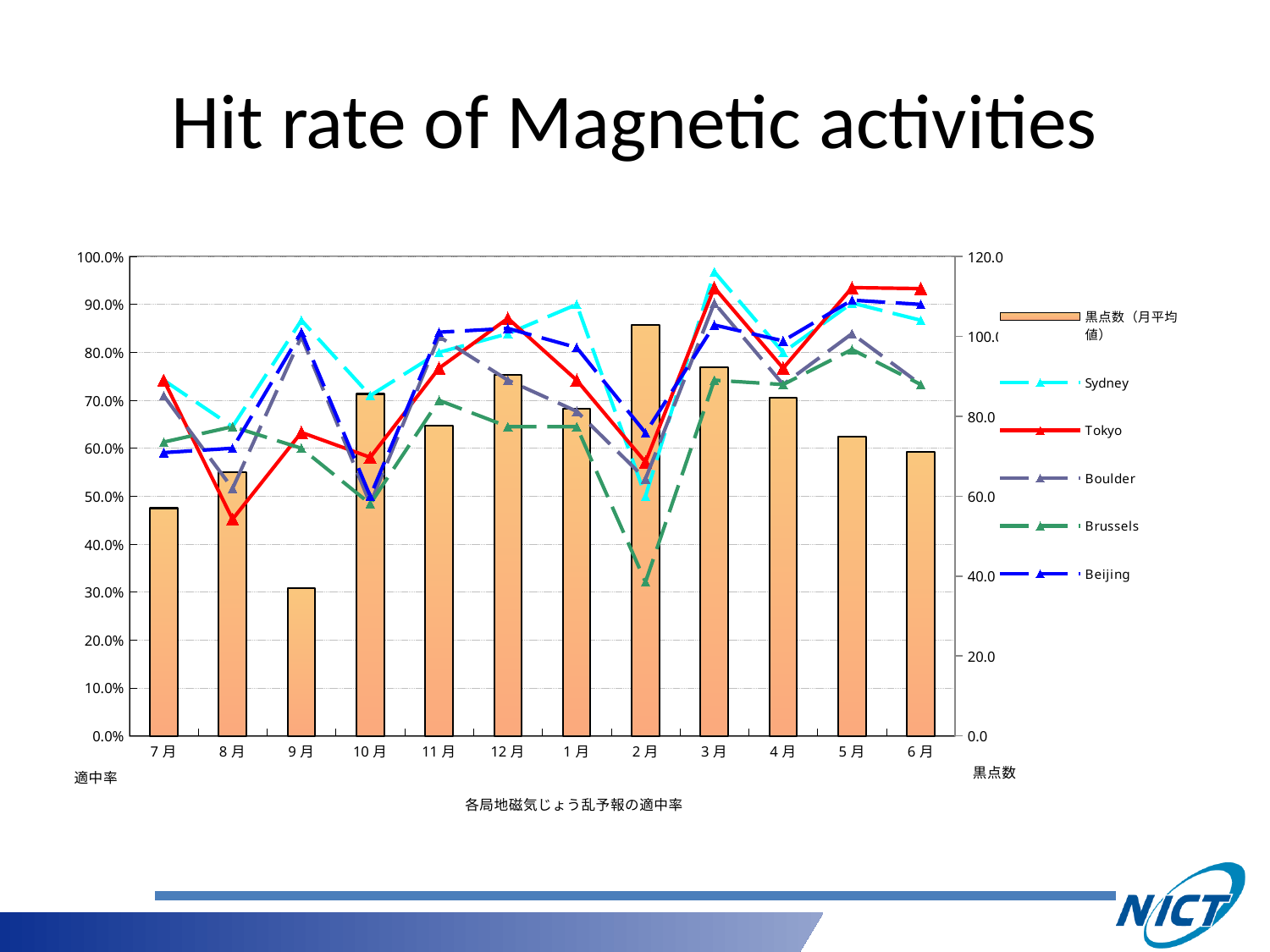
In which month is the sunspot number (黒点数) bar the highest? 2月 In which month does the Sydney line reach its lowest value? 2月 Is the Brussels hit rate in 2月 greater or less than 40.0%? less How many months are shown along the x axis? 12 Is the Tokyo hit rate in 8月 greater or less than 50.0%? less What kind of chart is shown on the slide? A combined bar and line chart In which month is the sunspot number (黒点数) bar the lowest? 9月 How many series does the legend list? 6 Is the sunspot number (黒点数) bar for 2月 greater or less than 100.0? greater In 8月, which has the higher hit rate, Tokyo or Brussels? Brussels In which month does the Sydney line reach its highest value? 3月 What is the title of the slide? Hit rate of Magnetic activities